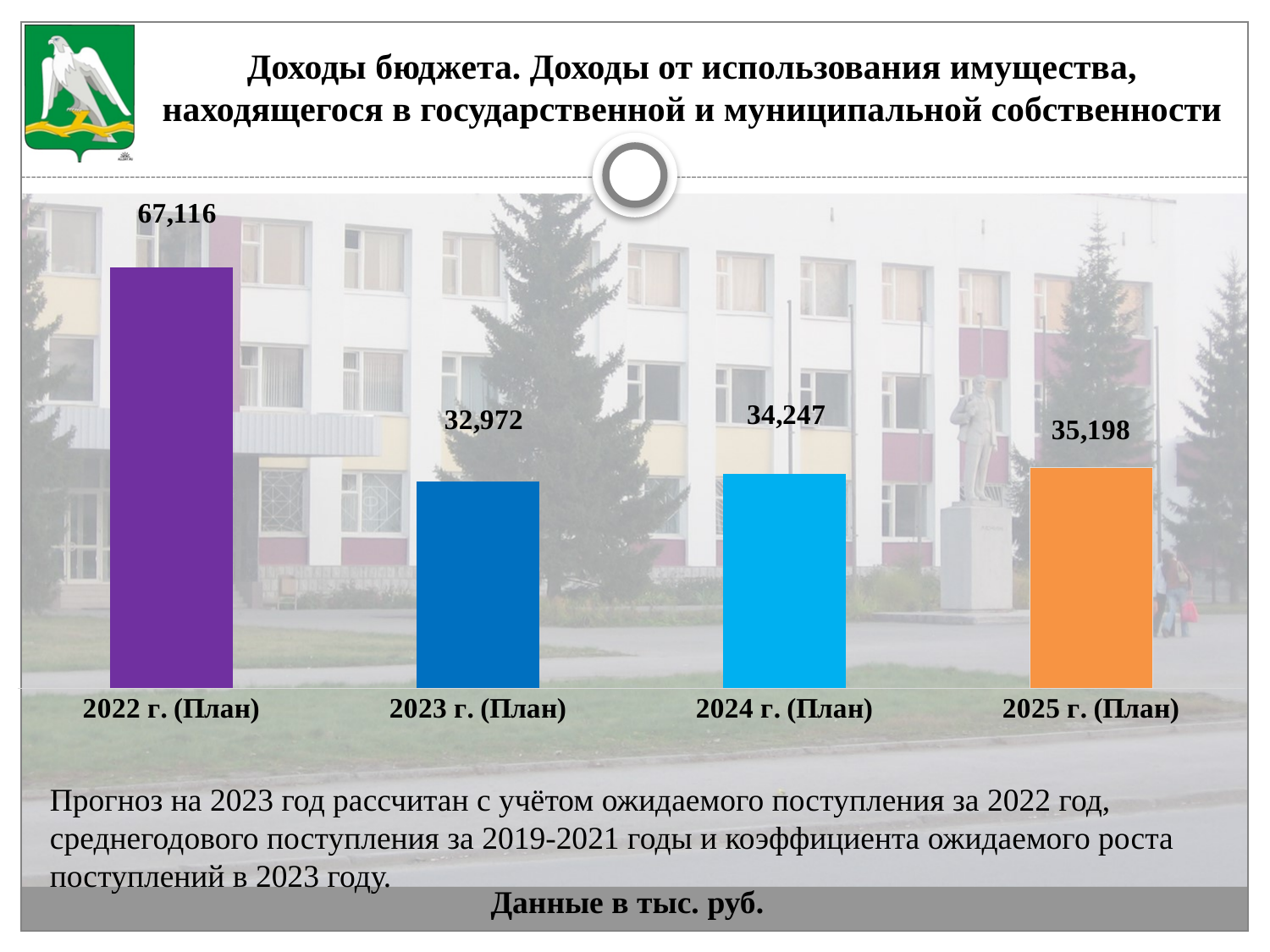
How many bars are shown in the chart? 4 What kind of chart is shown on the slide? Bar chart Which year has the lowest value? 2023 г. (План) What is the value for 2022 г. (План)? 67,116 What is the value for 2024 г. (План)? 34,247 What is the value for 2023 г. (План)? 32,972 Which is larger, the value for 2024 г. (План) or 2025 г. (План)? 2025 г. (План) Which year has the highest value? 2022 г. (План) What is the difference between the values for 2022 г. (План) and 2023 г. (План)? 34,144 What is the value for 2025 г. (План)? 35,198 Do the values rise or fall from 2023 г. (План) to 2025 г. (План)? Rise What is the difference between the values for 2024 г. (План) and 2023 г. (План)? 1,275